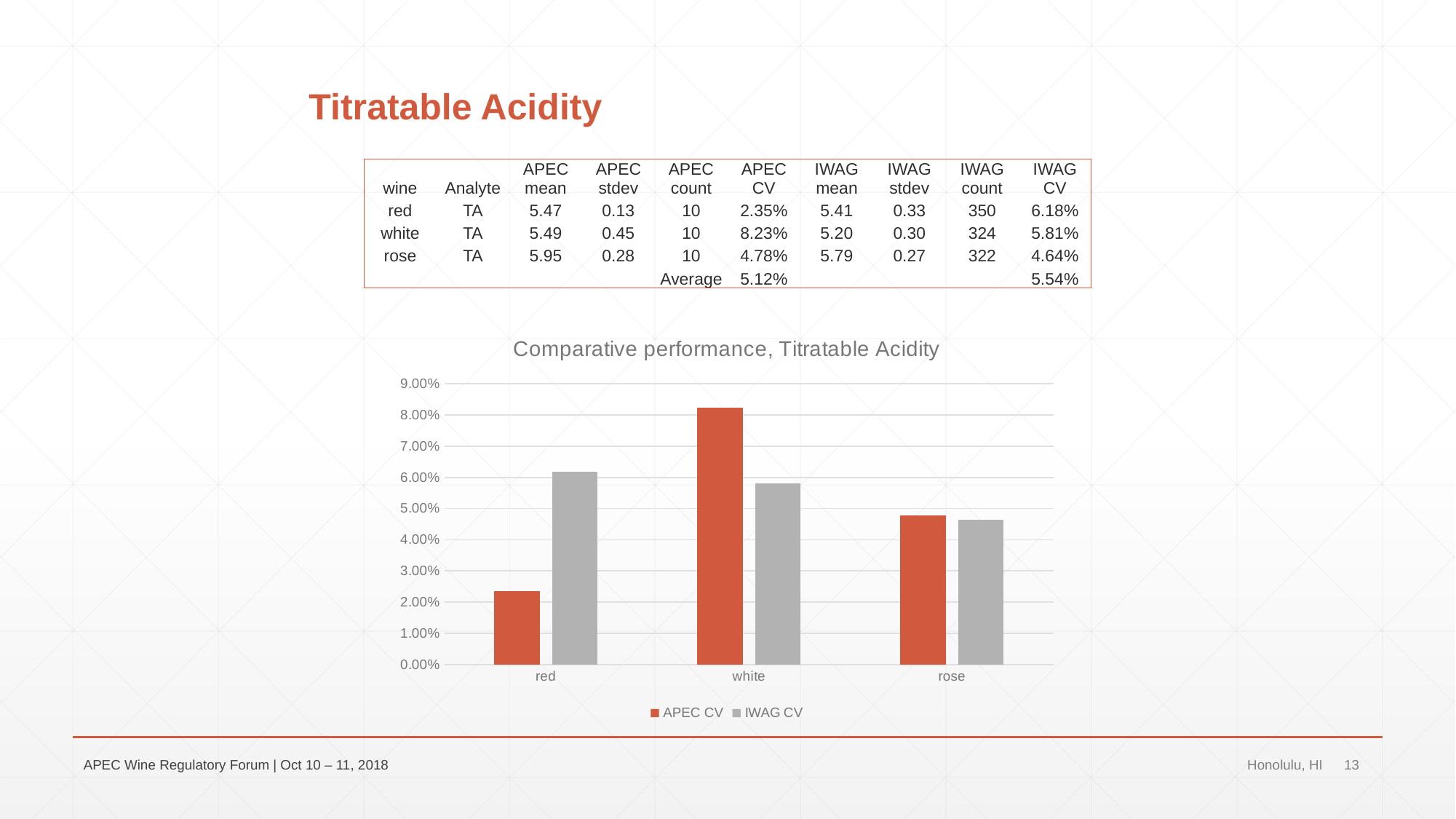
What is the title of the chart? Comparative performance, Titratable Acidity For red wine, which is larger in the chart: APEC CV or IWAG CV? IWAG CV Which wine has the lowest APEC CV bar in the chart? red Is the APEC CV value for red wine greater or less than 3.00%? less Which wine has the lowest IWAG CV bar in the chart? rose Is the IWAG CV value for red wine greater or less than 6.00%? greater What kind of chart is shown on the slide? bar chart Is the APEC CV value for white wine greater or less than 8.00%? greater For white wine, which is larger in the chart: APEC CV or IWAG CV? APEC CV How many series does the chart legend list? 2 Which wine has the highest APEC CV bar in the chart? white How many wine categories are shown on the x axis of the chart? 3